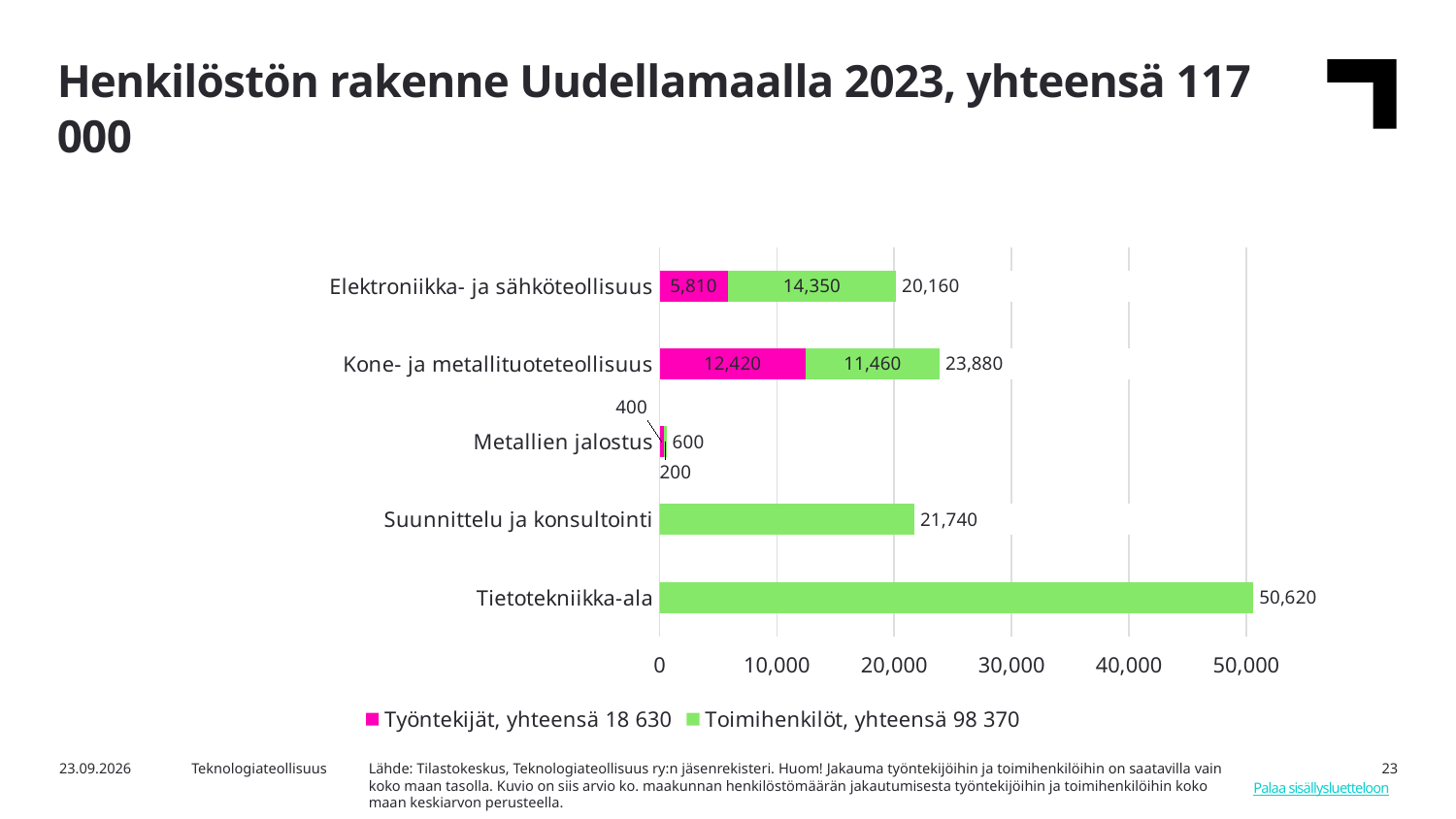
Which is larger: the Työntekijät value for Kone- ja metallituoteteollisuus or the Työntekijät value for Elektroniikka- ja sähköteollisuus? Kone- ja metallituoteteollisuus How many categories are shown on the chart? 5 What is the difference between the Työntekijät and Toimihenkilöt values for Elektroniikka- ja sähköteollisuus? 8,540 What kind of chart is shown on the slide? Stacked bar chart How many series does the legend list? 2 Which category has the lowest total value? Metallien jalostus Which category has the highest total value? Tietotekniikka-ala What is the value for Tietotekniikka-ala? 50,620 What is the total of the stacked bar for Kone- ja metallituoteteollisuus? 23,880 What is the Työntekijät value for Kone- ja metallituoteteollisuus? 12,420 What is the Toimihenkilöt value for Elektroniikka- ja sähköteollisuus? 14,350 What is the value for Suunnittelu ja konsultointi? 21,740